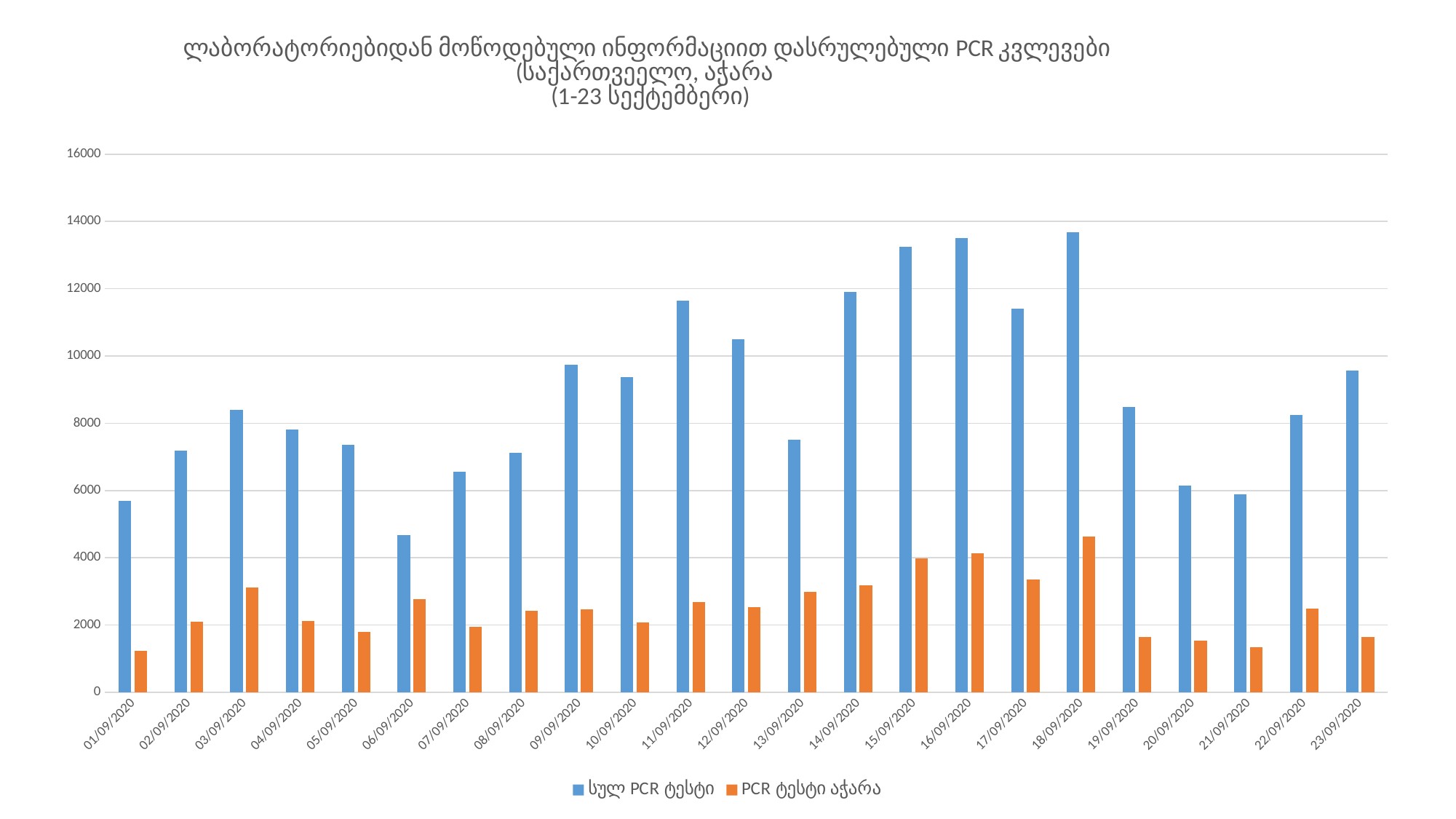
Is the სულ PCR ტესტი value for 06/09/2020 greater or less than 6000? less Is the სულ PCR ტესტი value for 01/09/2020 greater or less than 4000? greater How many dates are shown along the x axis? 23 Which colour represents the სულ PCR ტესტი series? blue Which date has the highest value for the PCR ტესტი აჭარა series? 18/09/2020 Which date has the larger სულ PCR ტესტი value, 02/09/2020 or 03/09/2020? 03/09/2020 Do the სულ PCR ტესტი values rise or fall from 18/09/2020 to 21/09/2020? fall How many series does the legend list? 2 What kind of chart is shown on the slide? bar chart Which date has the lowest value for the სულ PCR ტესტი series? 06/09/2020 Is the სულ PCR ტესტი value for 11/09/2020 greater or less than 10000? greater